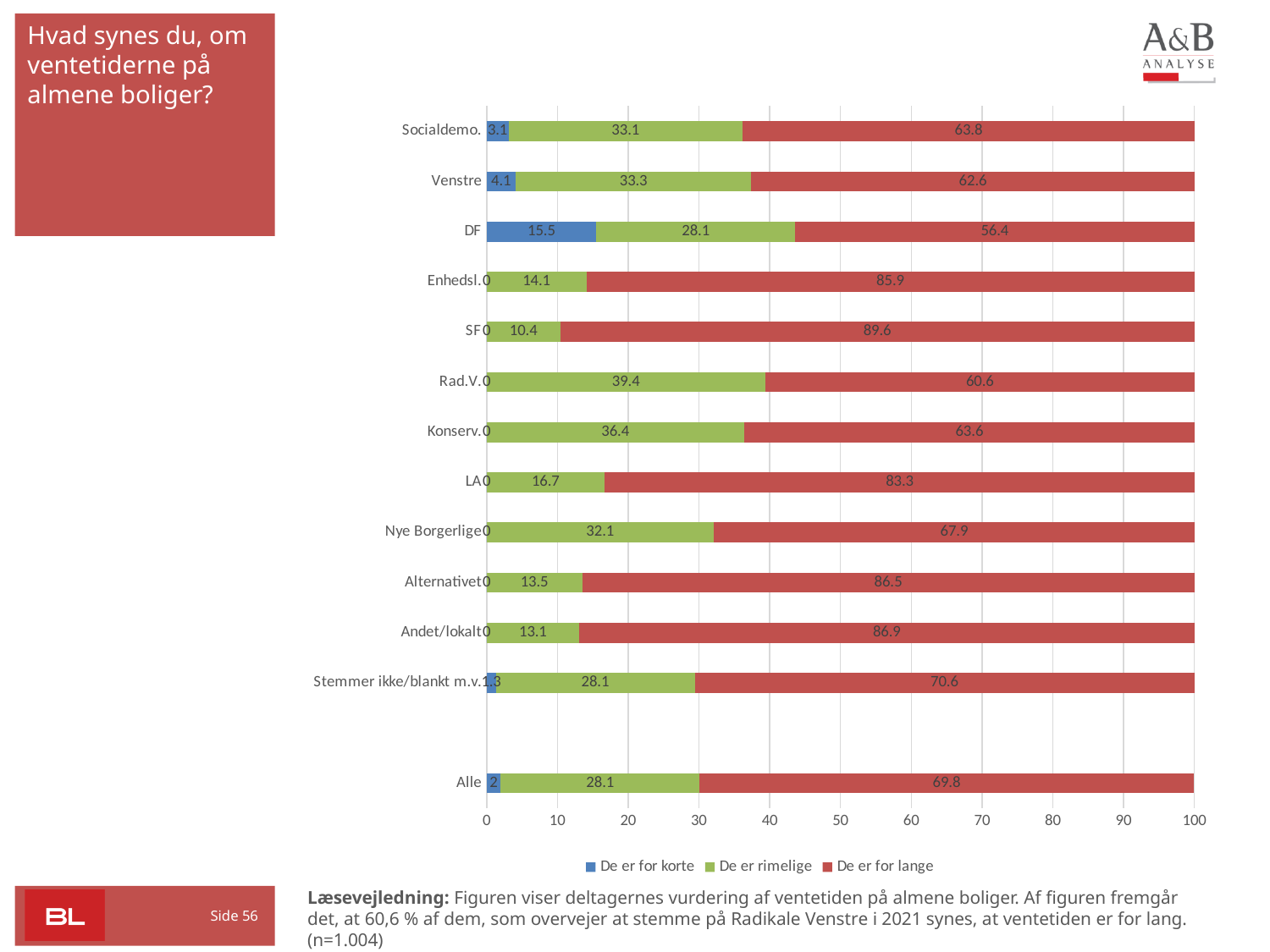
Which series is shown in red in the chart? De er for lange Which is larger: the "De er rimelige" value for Konserv. or for Nye Borgerlige? Konserv. What is the difference between the "De er for lange" values for Enhedsl. and Venstre? 23.3 How many categories are shown on the y axis of the chart? 13 What is the value of "De er rimelige" for Rad.V.? 39.4 What is the total of the stacked bar for Alle? 99.9 How many series does the legend list? 3 What is the value of "De er for lange" for SF? 89.6 Which category has the highest value for "De er for lange"? SF What kind of chart is shown on the slide? Stacked bar chart Which category has the lowest value for "De er for lange"? DF What is the value of "De er for korte" for DF? 15.5